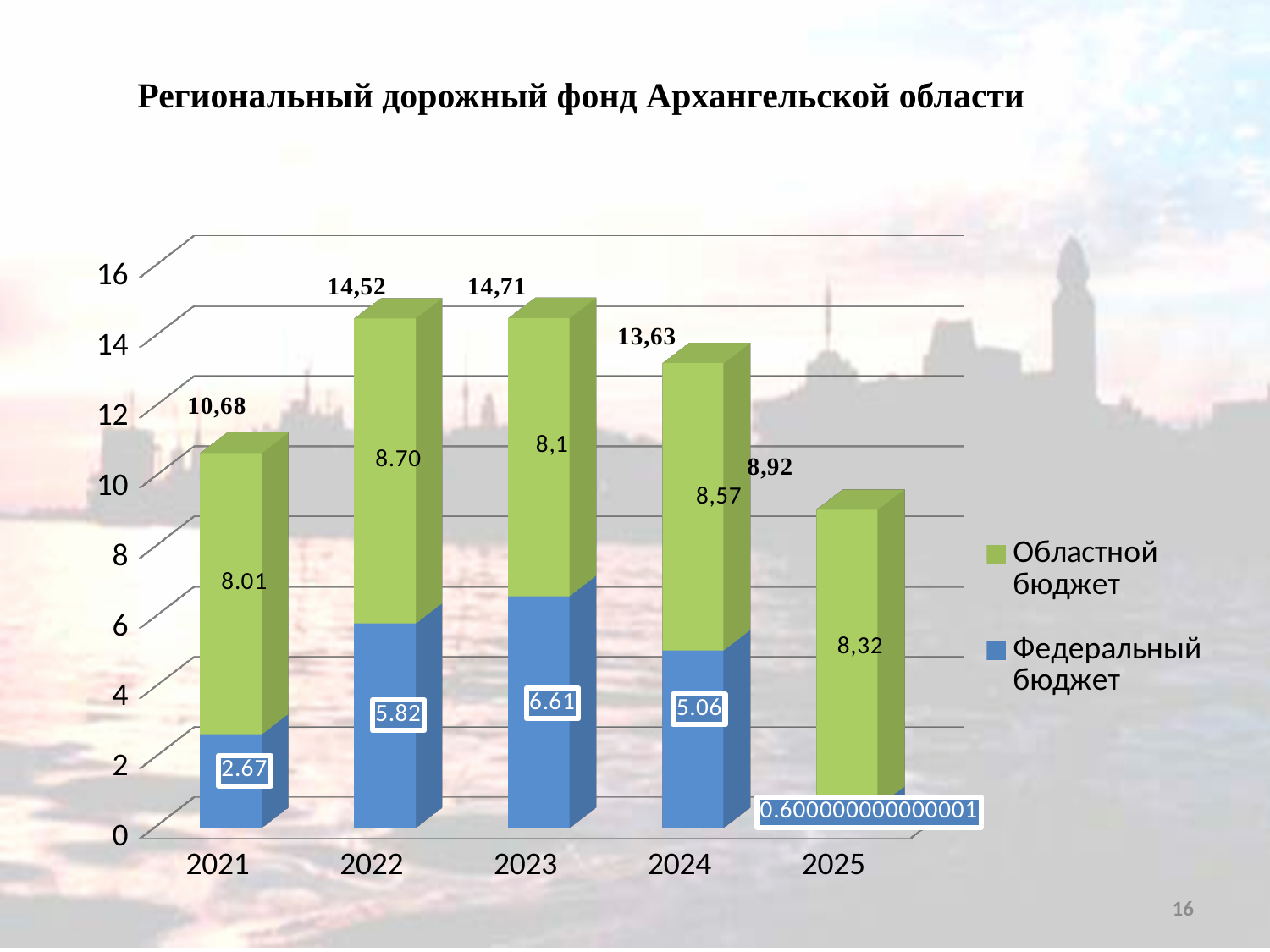
What is the total labelled above the stacked bar for 2025? 8,92 Which year has the highest total? 2023 What is the difference between the Федеральный бюджет values for 2022 and 2021? 3.15 Which is larger, the Федеральный бюджет value for 2023 or for 2024? 2023 What is the value for Федеральный бюджет in 2021? 2.67 Which year has the lowest value for Федеральный бюджет? 2025 What kind of chart is shown on the slide? Stacked bar chart What is the total labelled above the stacked bar for 2023? 14,71 How many series does the legend list? 2 How many years are shown on the x axis? 5 What is the value for Федеральный бюджет in 2023? 6.61 What is the value for Областной бюджет in 2022? 8.70